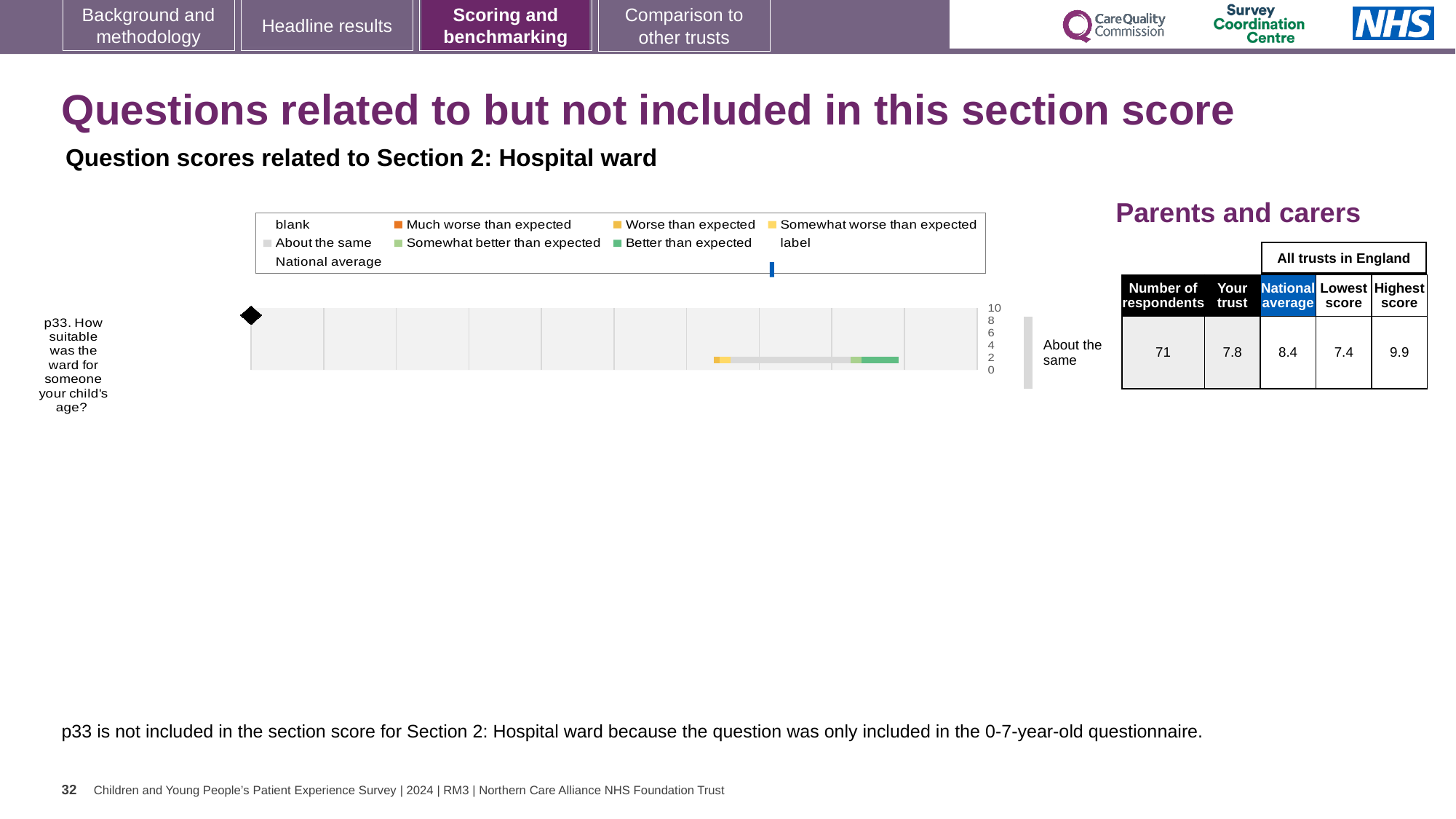
What is the maximum value shown on the chart's score axis? 10 What kind of chart is shown on the slide? bar chart How many questions (categories) are plotted in the chart? 1 What is the 'Your trust' score for p33? 7.8 What is the difference between the highest score and the lowest score for p33? 2.5 Which question is plotted in the chart? p33. How suitable was the ward for someone your child's age? Which is larger for p33, the trust's score or the national average? national average What is the lowest score among all trusts in England for p33? 7.4 What is the national average score for p33? 8.4 What is the highest score among all trusts in England for p33? 9.9 What benchmark category is p33 assigned to? About the same How many respondents answered p33? 71